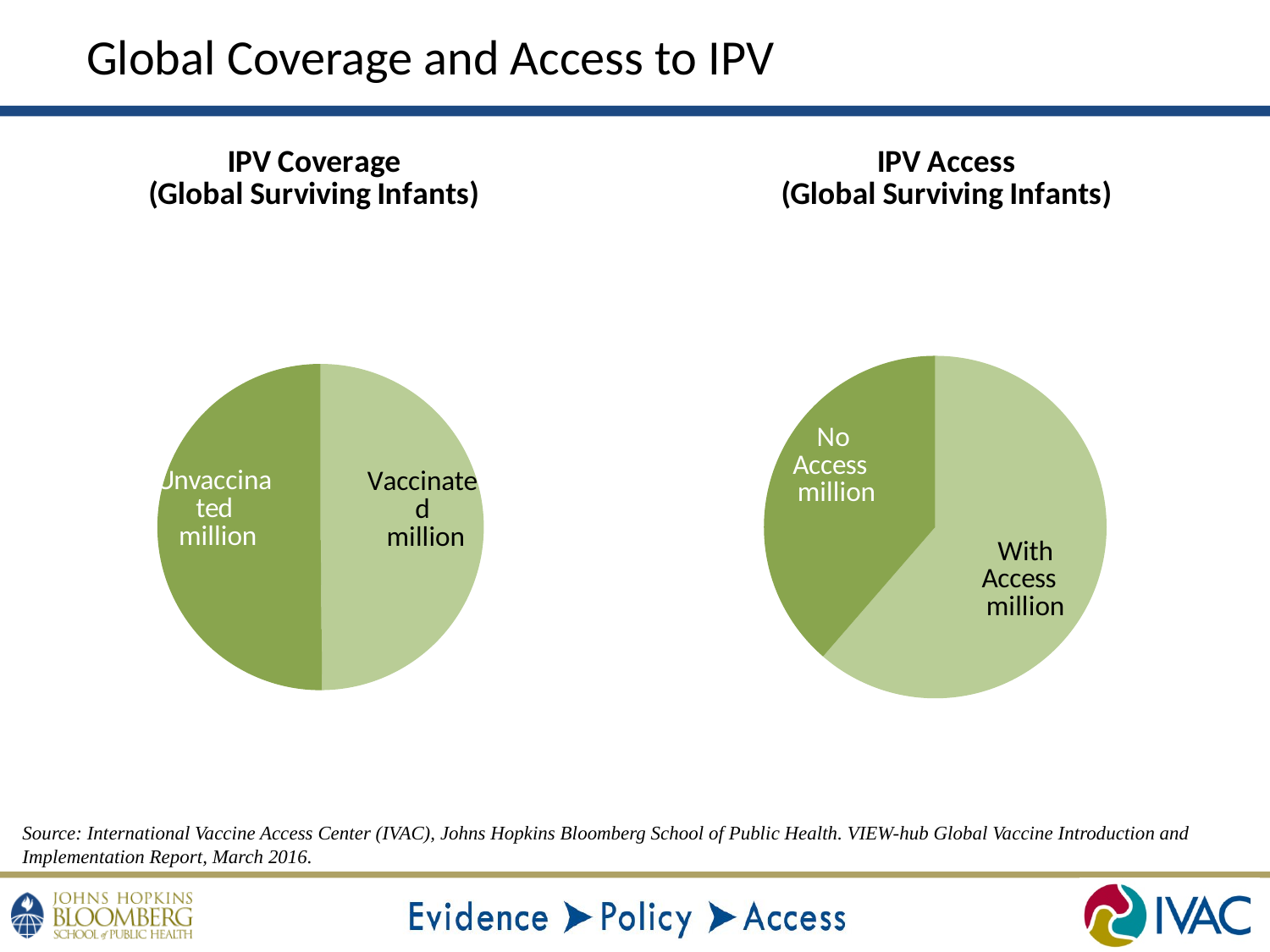
In the IPV Access (Global Surviving Infants) chart, which slice is larger: With Access or No Access? With Access In the IPV Access (Global Surviving Infants) chart, which slice is the smallest? No Access How many slices does the IPV Coverage (Global Surviving Infants) pie chart have? 2 How many slices does the IPV Access (Global Surviving Infants) pie chart have? 2 What is the title of the pie chart on the right side of the slide? IPV Access (Global Surviving Infants) How many charts are shown on the slide? 2 What kind of chart is the IPV Coverage (Global Surviving Infants) chart? pie chart In the IPV Access (Global Surviving Infants) chart, which slice is the largest? With Access What are the two slice labels in the IPV Coverage (Global Surviving Infants) pie chart? Unvaccinated and Vaccinated What kind of chart is the IPV Access (Global Surviving Infants) chart? pie chart